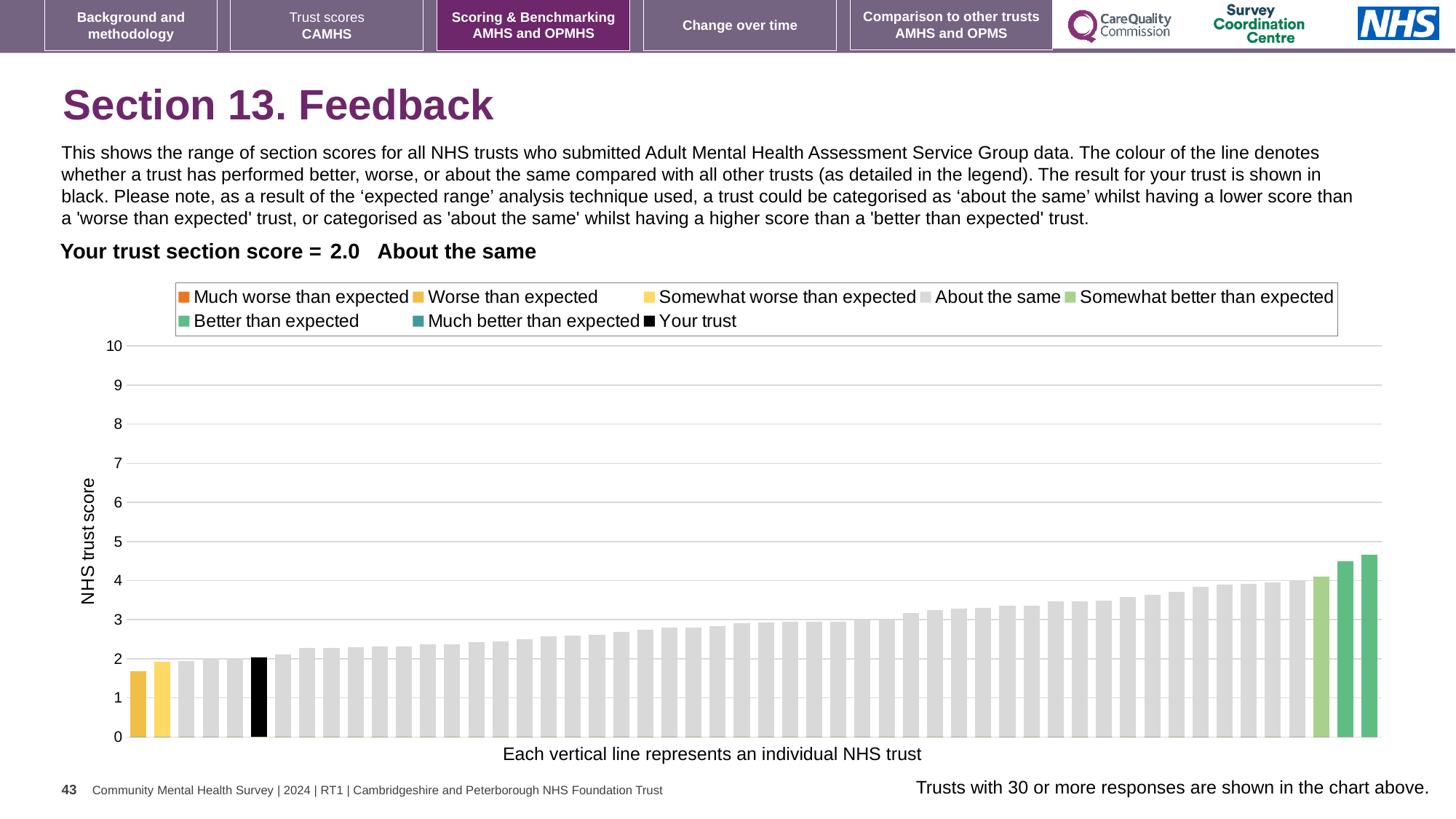
What is the section score for Your trust? 2.0 Is the value of the tallest bar greater or less than 4? greater What is the highest value shown on the vertical axis? 10 Is the value of the tallest bar greater or less than 5? less Is the value for Your trust greater or less than 3? less How is Your trust categorised compared with other trusts? About the same Do the bar values rise or fall from left to right along the x axis? rise How many entries does the chart legend list? 8 What kind of chart is shown on the slide? bar chart What is the label on the vertical axis? NHS trust score What colour is the bar representing Your trust? black